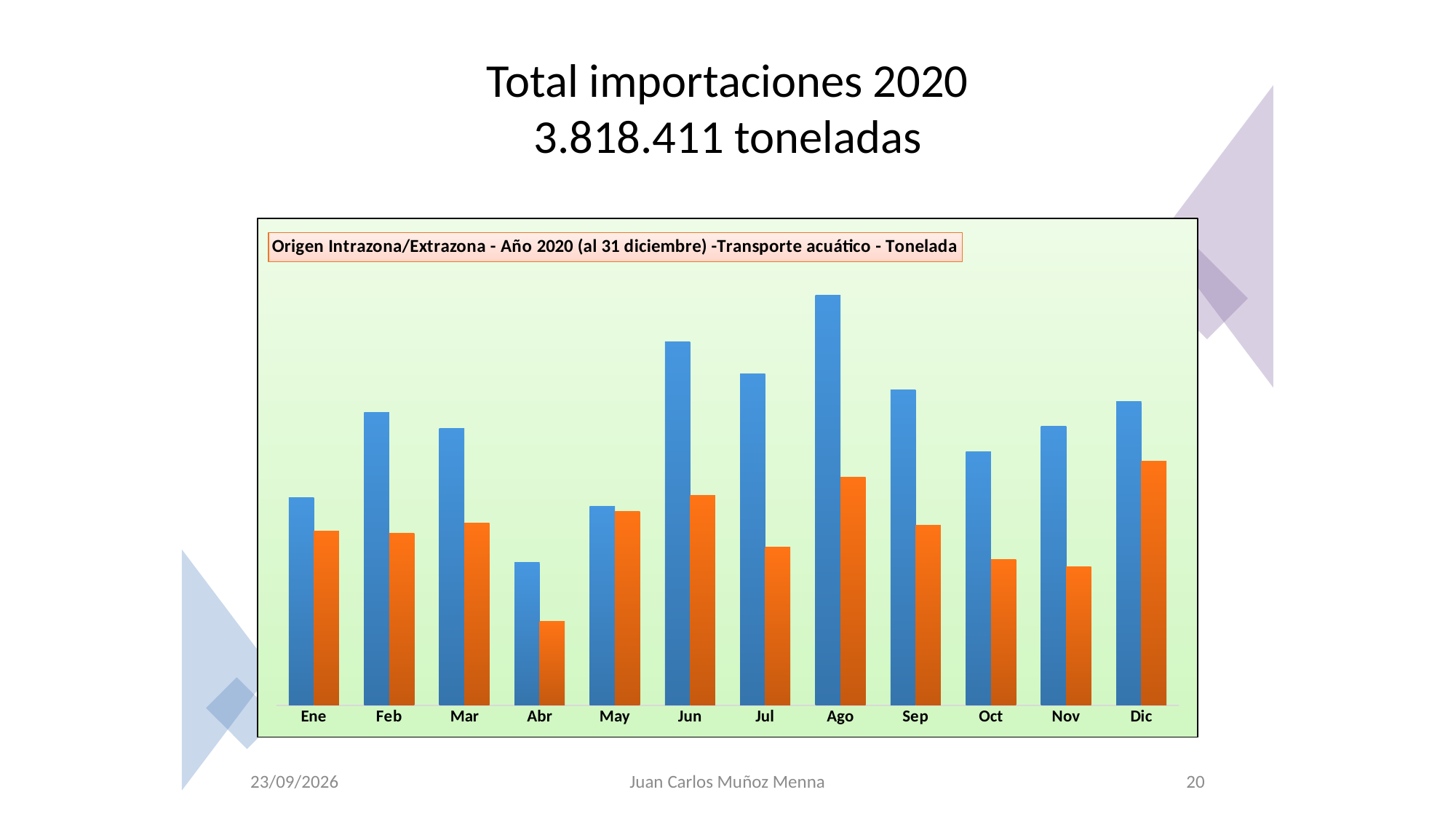
What kind of chart is shown on the slide? bar chart Which month has the shortest blue bar? Abr Is the blue bar taller in Jun or in Jul? Jun Which month has the tallest blue bar? Ago How many months (categories) are shown on the x axis of the chart? 12 Do the blue bars rise or fall from Abr to Jun? rise Is the orange bar taller in Ago or in Jul? Ago Which month has the tallest orange bar? Dic In Ene, which bar is taller, the blue one or the orange one? the blue one Which month has the shortest orange bar? Abr What is the title shown inside the chart area? Origen Intrazona/Extrazona - Año 2020 (al 31 diciembre) -Transporte acuático - Tonelada How many bars are plotted for each month? 2